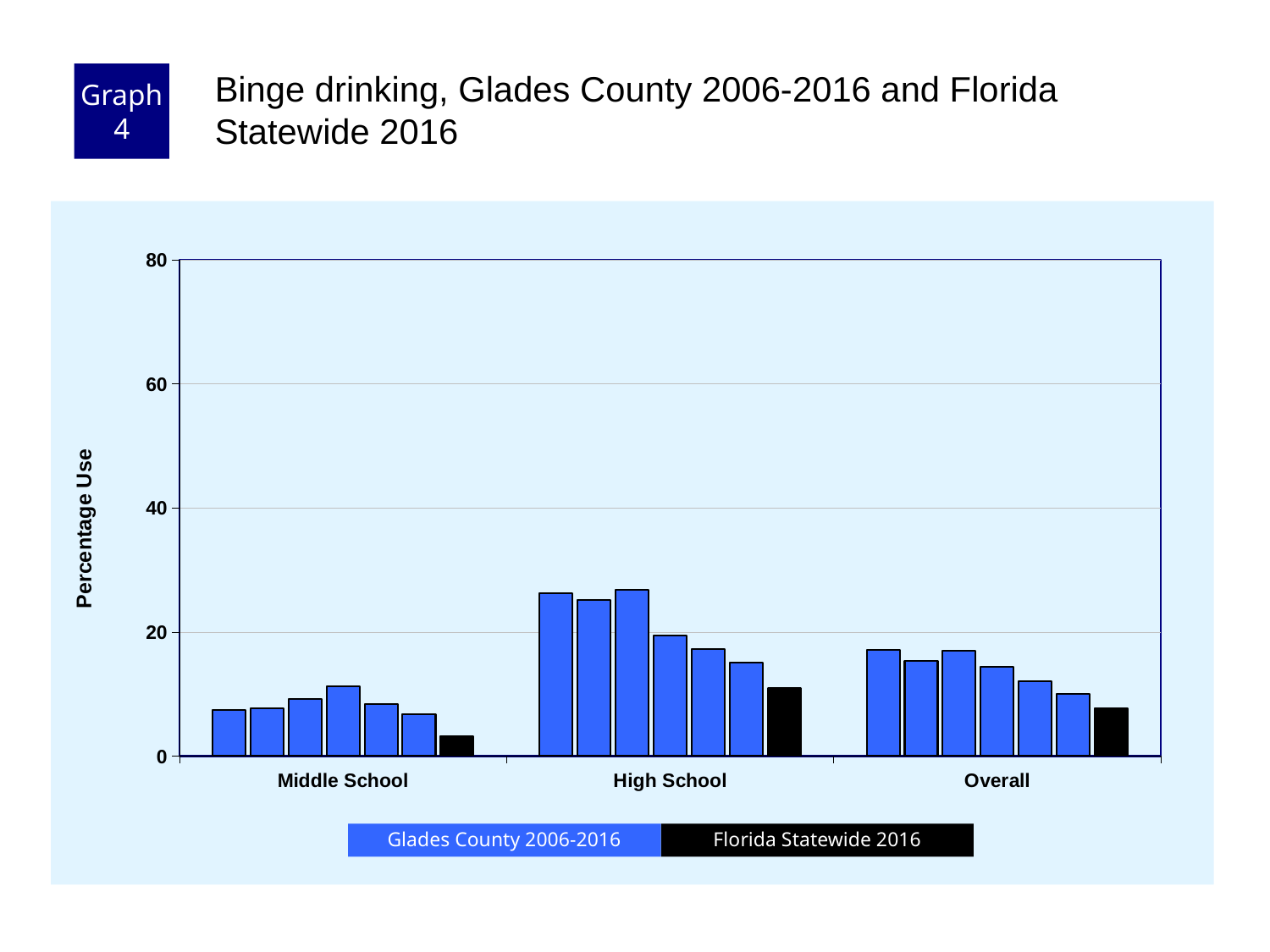
Which category has the lowest Florida Statewide 2016 value? Middle School What is the label on the y axis? Percentage Use How many categories are shown on the x axis? 3 What is the title of the chart? Binge drinking, Glades County 2006-2016 and Florida Statewide 2016 Is the Florida Statewide 2016 value for High School greater or less than 20? less What kind of chart is shown on the slide? bar chart Is the tallest Glades County bar for High School greater or less than 20? greater Which is larger, the Florida Statewide 2016 value for High School or for Middle School? High School Which category has the highest Florida Statewide 2016 value? High School Is the tallest Glades County bar for Middle School greater or less than 20? less How many series does the legend list? 2